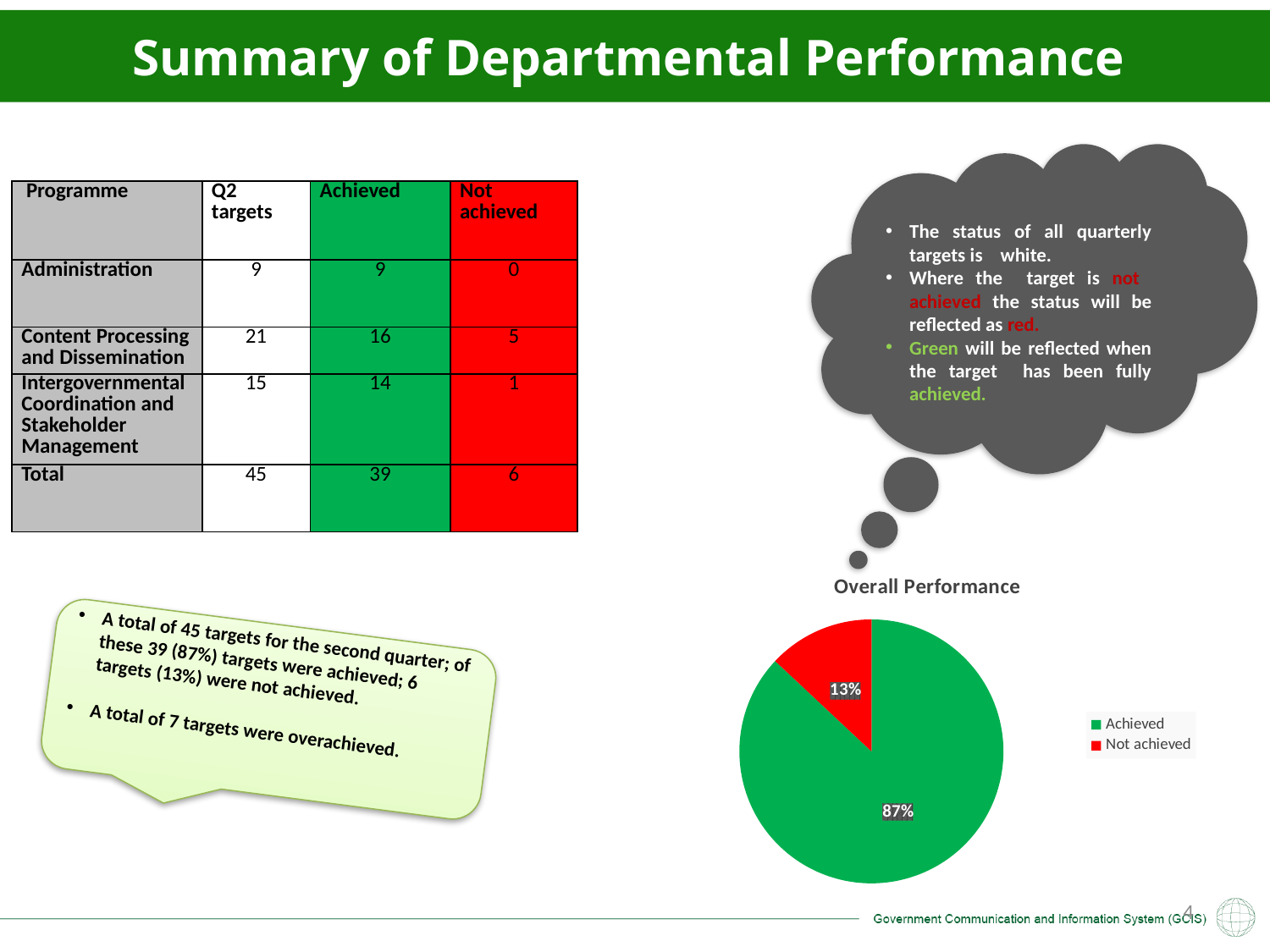
What type of chart is shown under the title "Overall Performance"? Pie chart What colour represents Not achieved in the Overall Performance pie chart? Red What is the title of the pie chart on the slide? Overall Performance In the Overall Performance pie chart, what percentage is shown for Not achieved? 13% How many entries does the legend of the Overall Performance pie chart list? 2 What is the difference in percentage points between the Achieved and Not achieved slices in the Overall Performance pie chart? 74 Which slice of the Overall Performance pie chart is the largest? Achieved Which slice of the Overall Performance pie chart is the smallest? Not achieved How many slices does the Overall Performance pie chart have? 2 In the Overall Performance pie chart, which is larger: Achieved or Not achieved? Achieved What share of the Overall Performance pie does the Achieved slice represent? 87% In the Overall Performance pie chart, what percentage is shown for Achieved? 87%